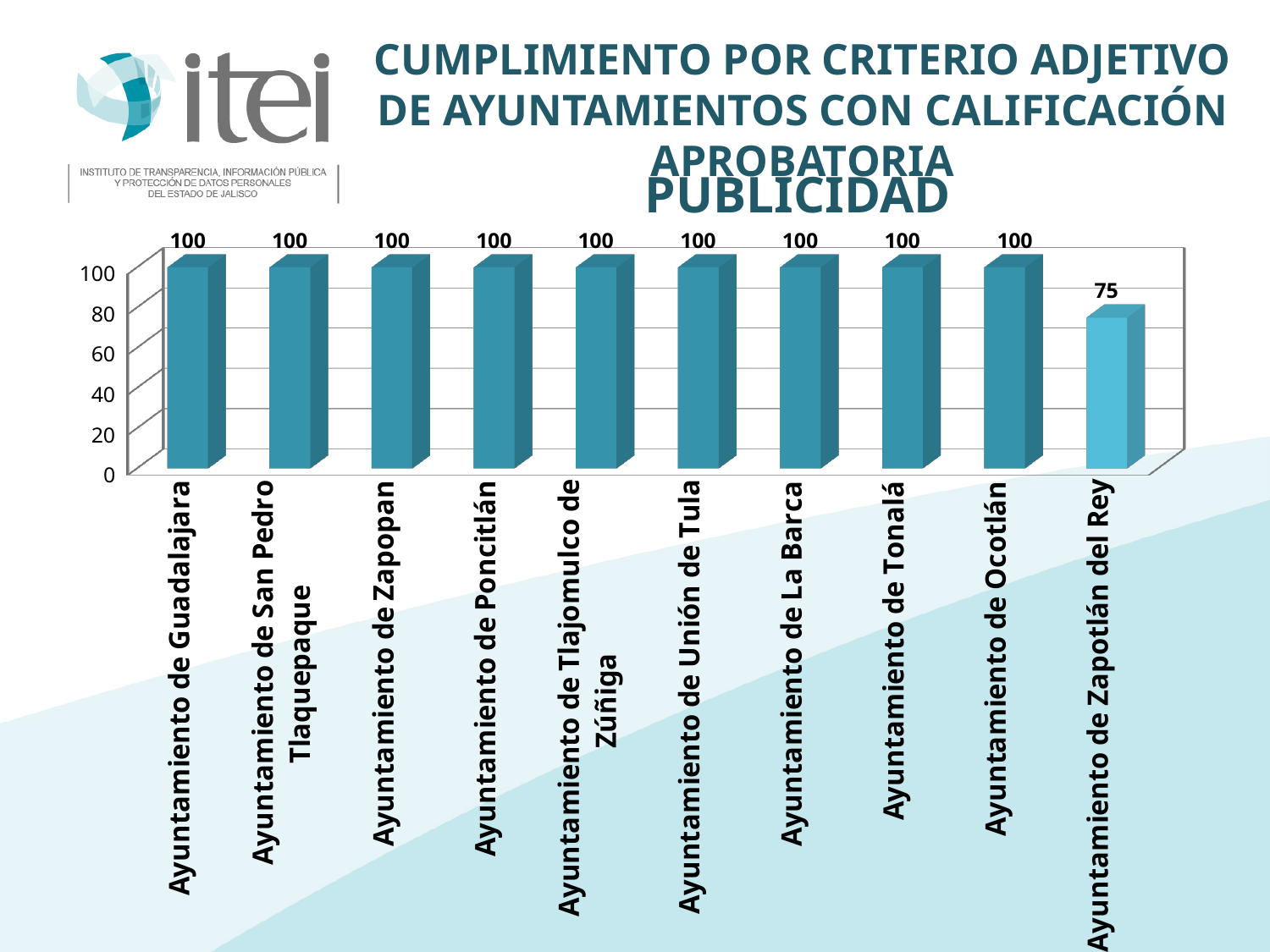
Which is larger, the value for Ayuntamiento de La Barca or the value for Ayuntamiento de Zapotlán del Rey? Ayuntamiento de La Barca What is the value for Ayuntamiento de Zapotlán del Rey? 75 Which bar is shown in a lighter shade of blue than the others? Ayuntamiento de Zapotlán del Rey What kind of chart is shown on the slide? Bar chart What is the value for Ayuntamiento de Guadalajara? 100 How many ayuntamientos have a value of 100? 9 What is the difference between the value for Ayuntamiento de Ocotlán and the value for Ayuntamiento de Zapotlán del Rey? 25 How many ayuntamientos are shown in the chart? 10 What is the value for Ayuntamiento de Tonalá? 100 Is the value for Ayuntamiento de Zapotlán del Rey greater or less than 80? less Which ayuntamiento has the lowest value? Ayuntamiento de Zapotlán del Rey What is the title of the chart? PUBLICIDAD